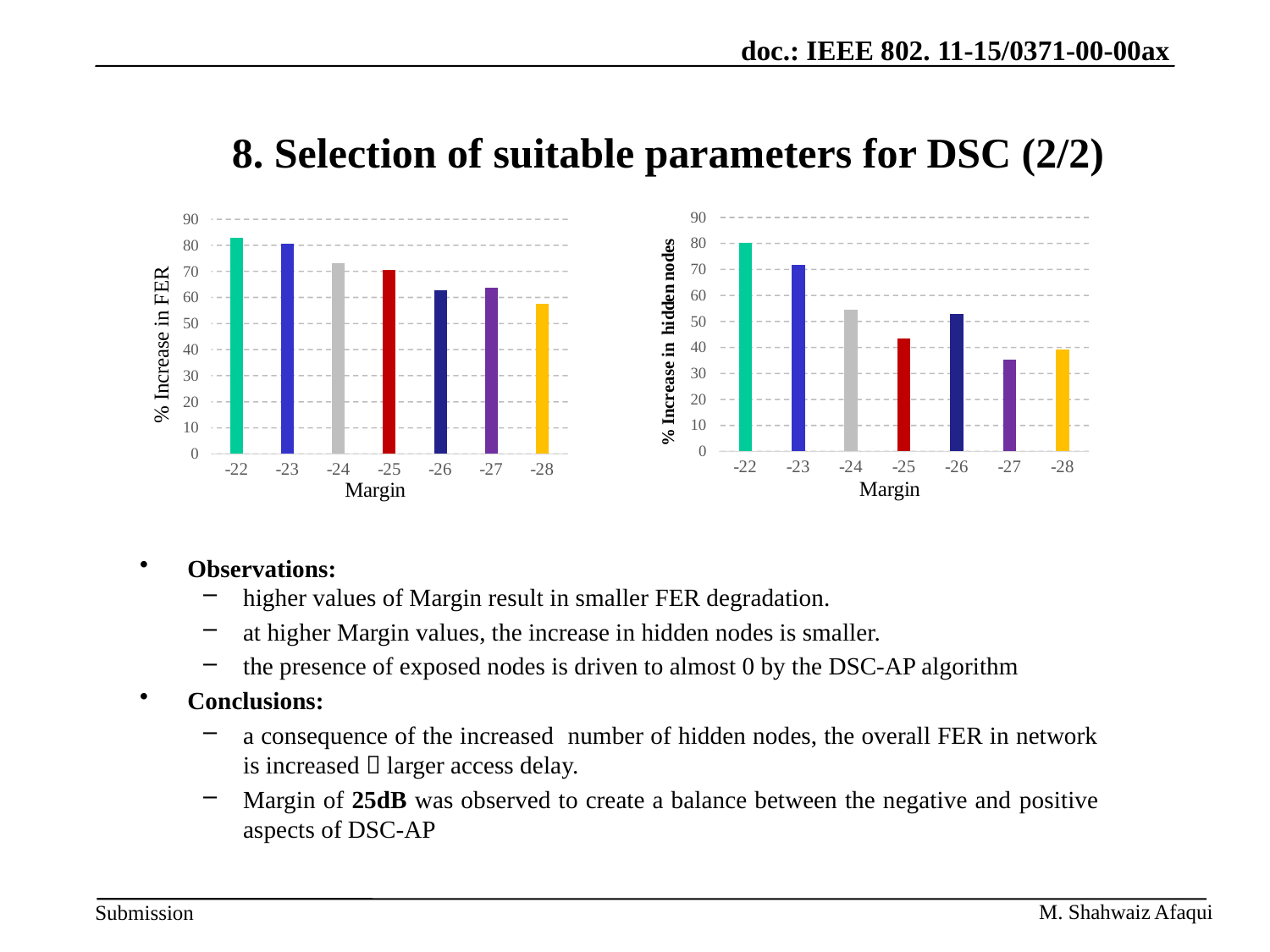
What is the x-axis label on the left chart? Margin On the left chart (% Increase in FER), do the values generally rise or fall as Margin goes from -22 to -28? fall What kind of chart is the left chart (% Increase in FER)? bar chart How many Margin categories are shown on the right chart (% Increase in hidden nodes)? 7 On the left chart (% Increase in FER), is the value for Margin -22 greater or less than 70? greater On the right chart (% Increase in hidden nodes), is the value for Margin -25 greater or less than 50? less On the left chart (% Increase in FER), which Margin value has the lowest bar? -28 On the right chart (% Increase in hidden nodes), which is larger, the value for Margin -23 or Margin -25? -23 On the right chart (% Increase in hidden nodes), which Margin value has the lowest bar? -27 On the right chart (% Increase in hidden nodes), which Margin value has the highest bar? -22 On the right chart (% Increase in hidden nodes), is the value for Margin -23 greater or less than 60? greater